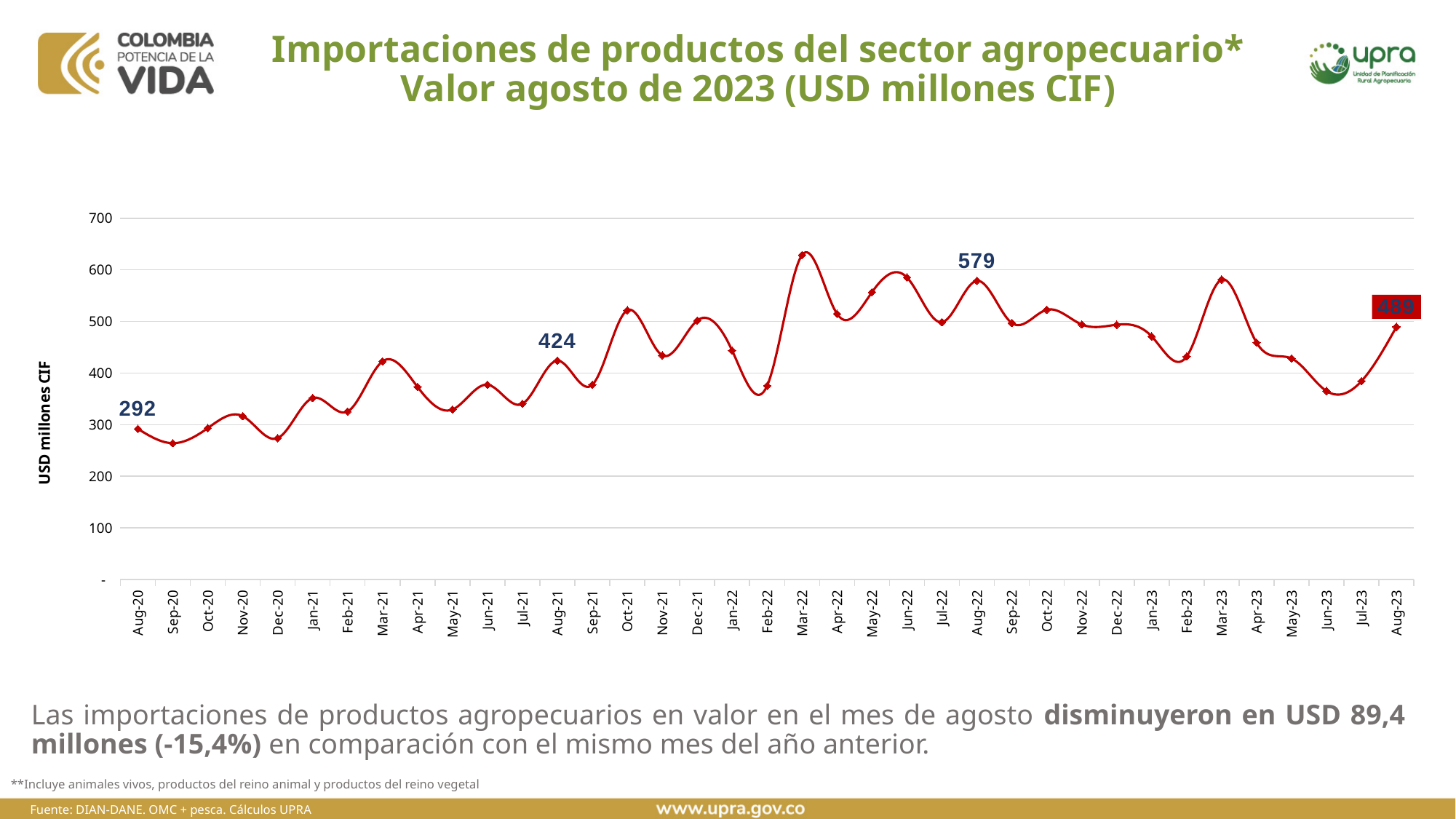
What is the difference between the values for Aug-22 and Aug-23? 90 Which is larger, the value for Aug-22 or the value for Aug-23? Aug-22 What is the value for Aug-22? 579 Is the value for Jun-23 greater or less than 400? less Which month has the highest value on the chart? Mar-22 Is the value for Mar-22 greater or less than 600? greater What is the difference between the values for Aug-21 and Aug-20? 132 What is the value for Aug-23? 489 What kind of chart is shown on the slide? Line chart What is the value for Aug-21? 424 What is the value for Aug-20? 292 How many monthly data points are plotted on the chart? 37